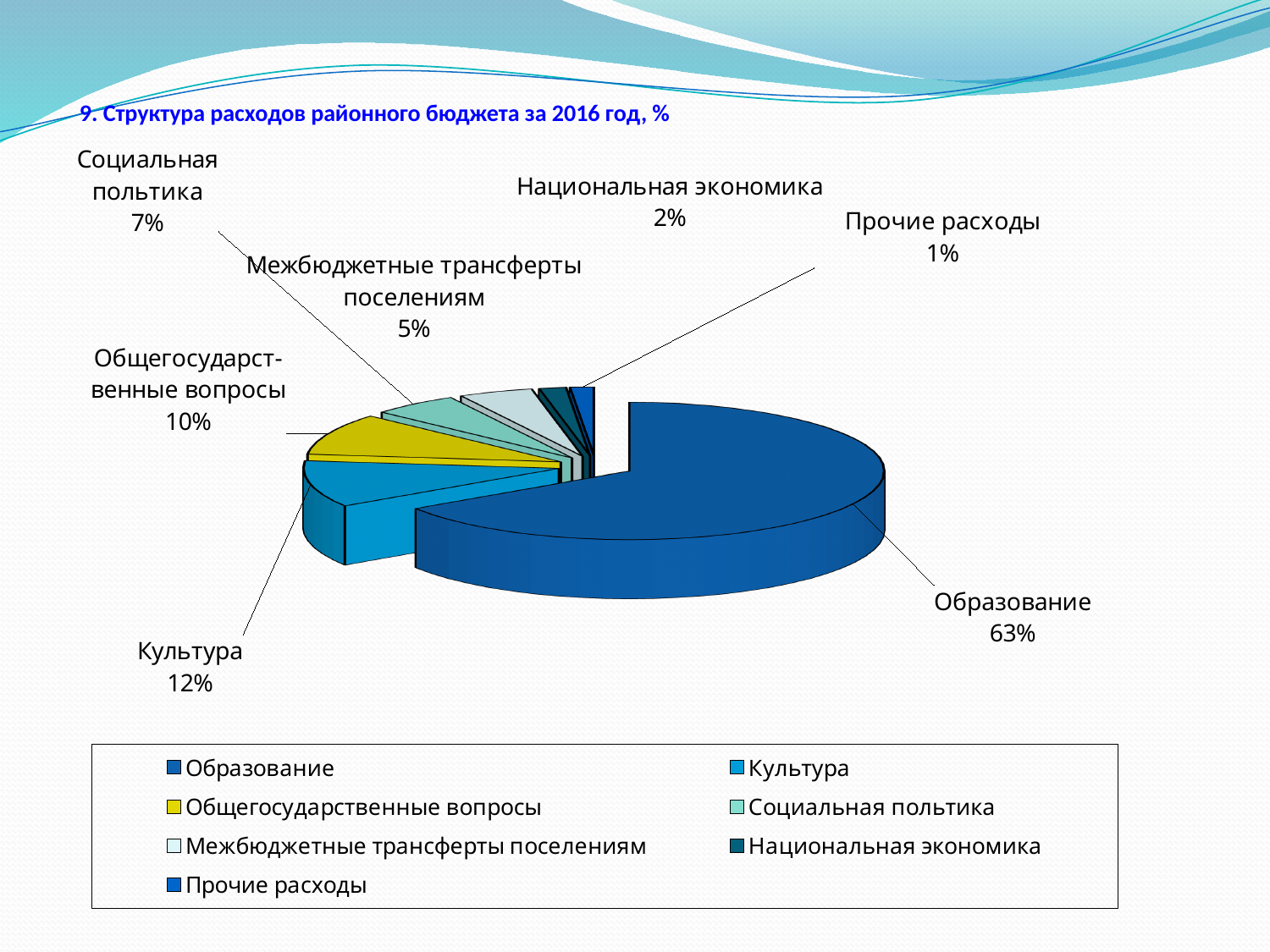
What percentage is shown for Социальная польтика? 7% Which category has the largest share of the pie? Образование How many categories does the pie chart have? 7 What share of the district budget expenditure goes to Образование? 63% What is the title of the chart? 9. Структура расходов районного бюджета за 2016 год, % What is the difference in percentage points between Образование and Культура? 51 Which category has the smallest share of the pie? Прочие расходы What percentage is shown for Культура? 12% What type of chart is shown on the slide? pie chart What percentage is shown for Межбюджетные трансферты поселениям? 5% What percentage is shown for Общегосударственные вопросы? 10% Which is larger, the share for Национальная экономика or the share for Социальная польтика? Социальная польтика